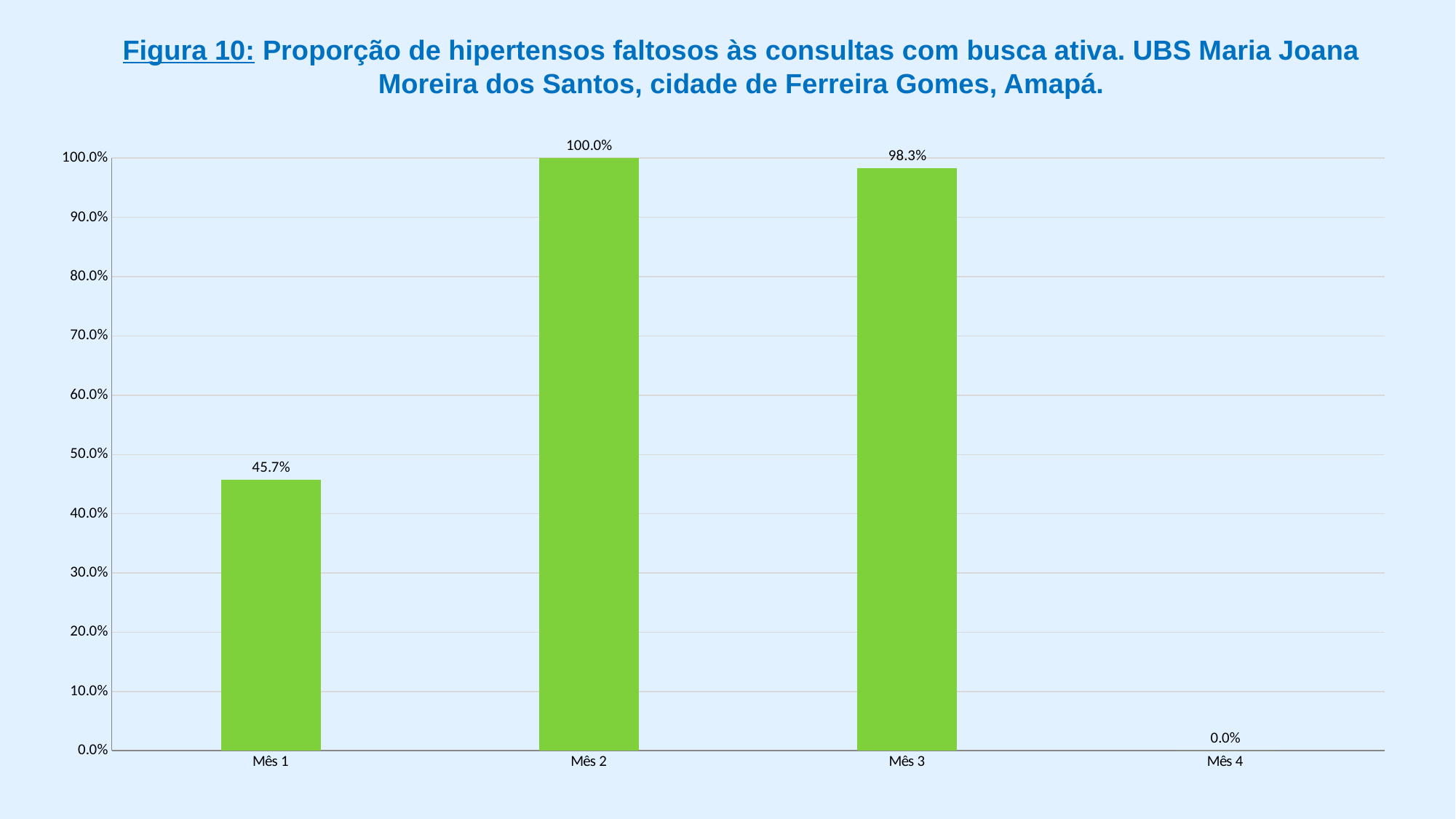
What colour are the bars in the chart? green How many months are shown on the x axis? 4 What is the difference between the values for Mês 2 and Mês 1? 54.3% Which is larger, the value for Mês 1 or the value for Mês 3? Mês 3 What kind of chart is shown on the slide? bar chart Which month has the lowest value? Mês 4 What is the difference between the values for Mês 2 and Mês 3? 1.7% What is the value for Mês 3? 98.3% Which month has the highest value? Mês 2 Is the value for Mês 1 greater or less than 50.0%? less What is the value for Mês 1? 45.7% What is the value for Mês 4? 0.0%